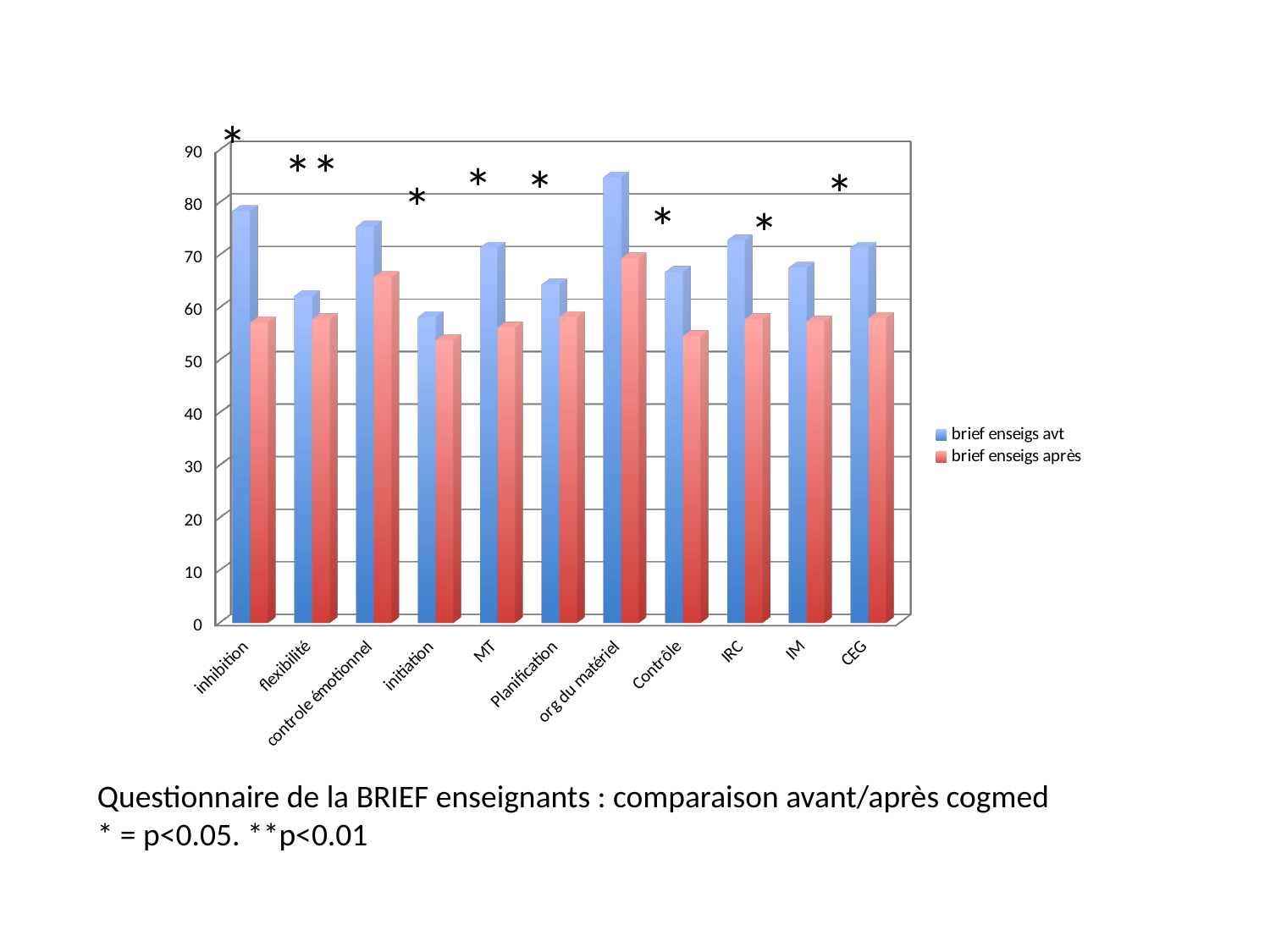
Is the 'brief enseigs avt' value for inhibition greater or less than 70? greater How many categories are shown on the x axis? 11 Which category has the highest value for the 'brief enseigs après' series? org du matériel Which category has the lowest value for the 'brief enseigs avt' series? initiation Which category has the highest value for the 'brief enseigs avt' series? org du matériel Is the 'brief enseigs après' value for controle émotionnel greater or less than 60? greater What kind of chart is shown on the slide? bar chart Is the 'brief enseigs avt' value for org du matériel greater or less than 80? greater For inhibition, which series has the larger value, 'brief enseigs avt' or 'brief enseigs après'? brief enseigs avt How many series does the legend list? 2 Which colour represents the 'brief enseigs après' series? red